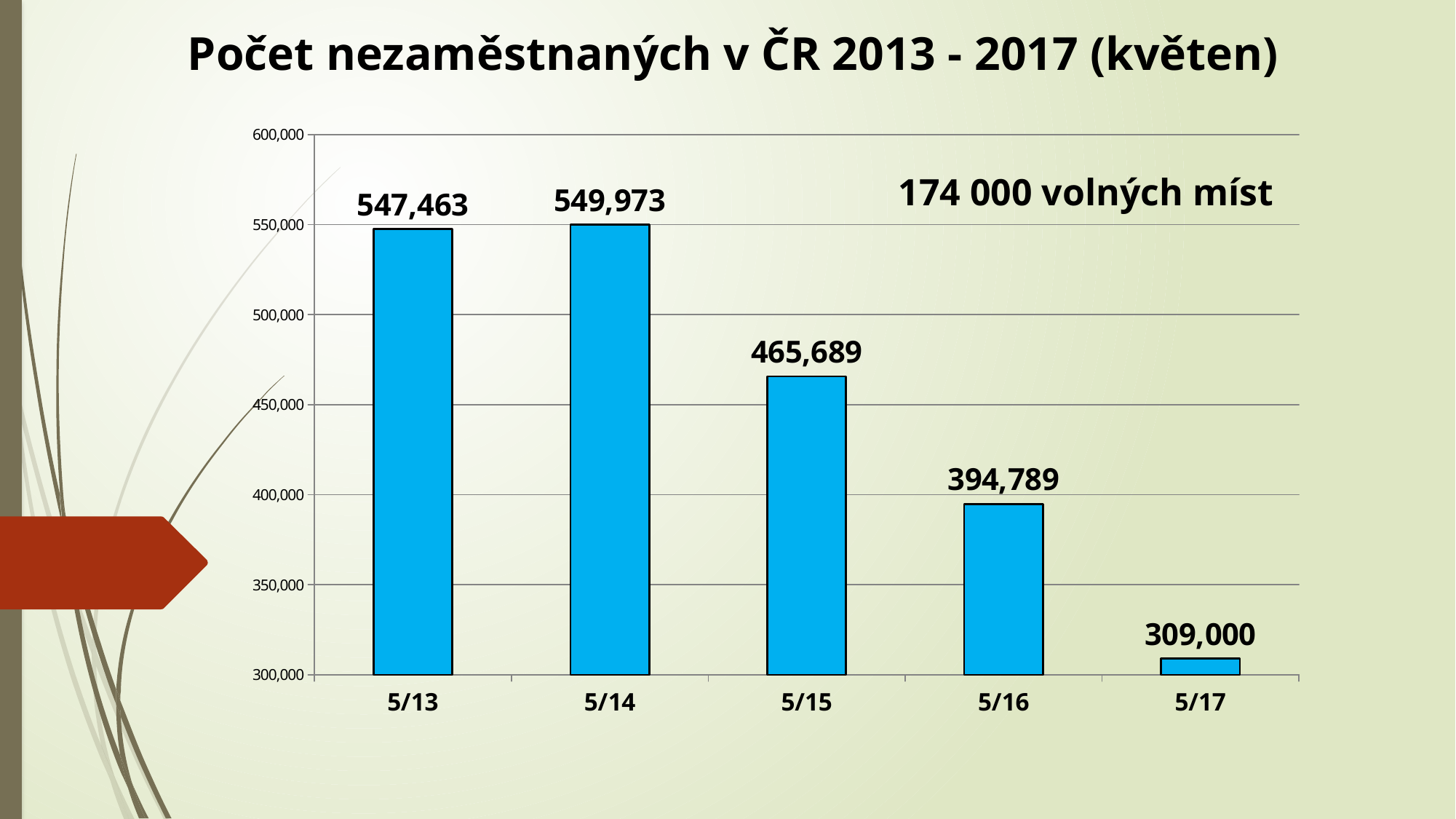
Which category has the lowest value? 5/17 Which is larger, the value for 5/15 or the value for 5/16? 5/15 What is the difference between the values for 5/14 and 5/13? 2,510 Which category has the highest value? 5/14 What is the value for 5/15? 465,689 Do the values rise or fall from 5/14 to 5/17? fall How many categories are shown on the x axis? 5 What kind of chart is shown on the slide? bar chart What is the value for 5/13? 547,463 What is the value for 5/17? 309,000 What is the difference between the values for 5/16 and 5/17? 85,789 Is the value for 5/16 greater or less than 400,000? less